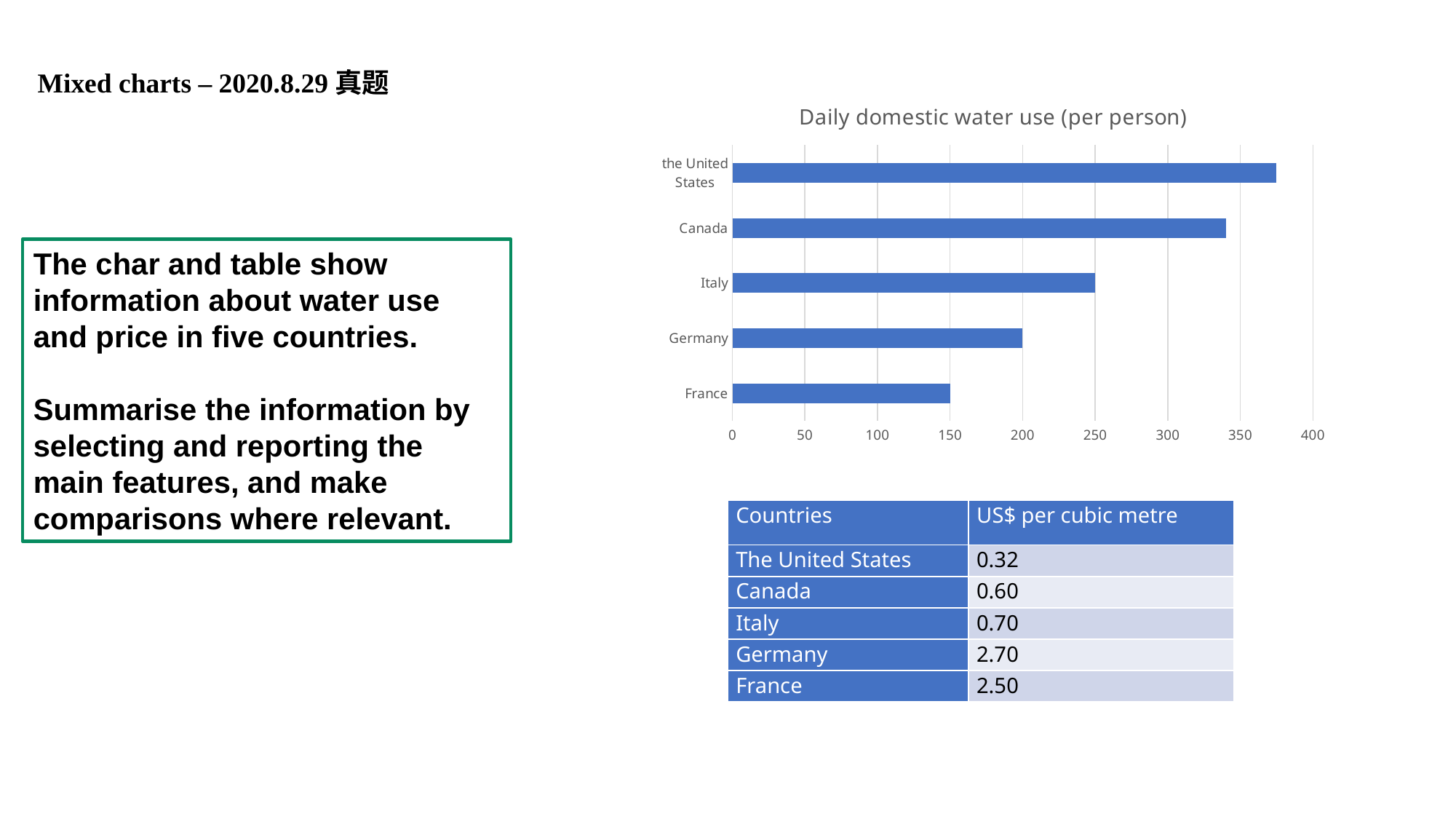
How many countries are shown in the chart? 5 Is the value for the United States in the chart greater or less than 350? greater What is the title of the chart? Daily domestic water use (per person) Is the value for Canada in the chart greater or less than 300? greater Which country has the lowest daily domestic water use per person in the chart? France What is the difference between the daily domestic water use per person of Italy and France in the chart? 100 In the chart, which has a higher daily domestic water use per person, Canada or Italy? Canada What type of chart is shown on the slide? bar chart What is the daily domestic water use per person for France in the chart? 150 What is the daily domestic water use per person for Italy in the chart? 250 Which country has the highest daily domestic water use per person in the chart? the United States What is the daily domestic water use per person for Germany in the chart? 200